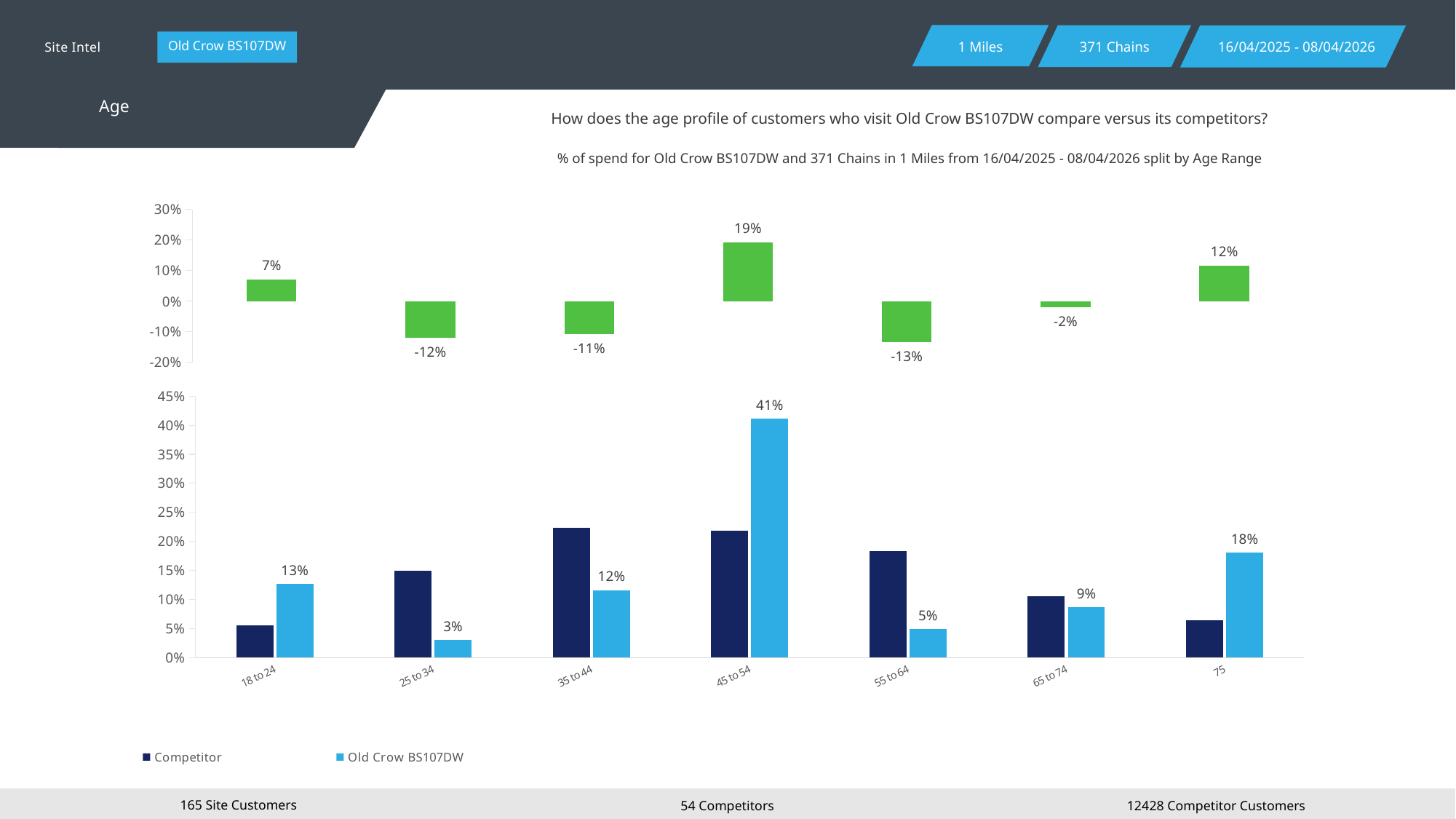
In the top chart, what is the value for the 45 to 54 age range? 19% In the top chart, which age range has the highest value? 45 to 54 In the bottom chart, what is the Old Crow BS107DW value for the 45 to 54 age range? 41% In the bottom chart, is the Competitor value for the 18 to 24 age range greater or less than 10%? less In the top chart, what is the value for the 55 to 64 age range? -13% In the bottom chart, is the Competitor value for the 35 to 44 age range greater or less than 20%? greater In the bottom chart, what is the Old Crow BS107DW value for the 25 to 34 age range? 3% In the top chart, which age range has the lowest value? 55 to 64 In the bottom chart, which is larger for the 35 to 44 age range: the Competitor bar or the Old Crow BS107DW bar? Competitor In the bottom chart, what is the difference between the Old Crow BS107DW values for 45 to 54 and 75? 23% How many series does the legend of the bottom chart list? 2 How many age range categories are shown on the x axis of the bottom chart? 7